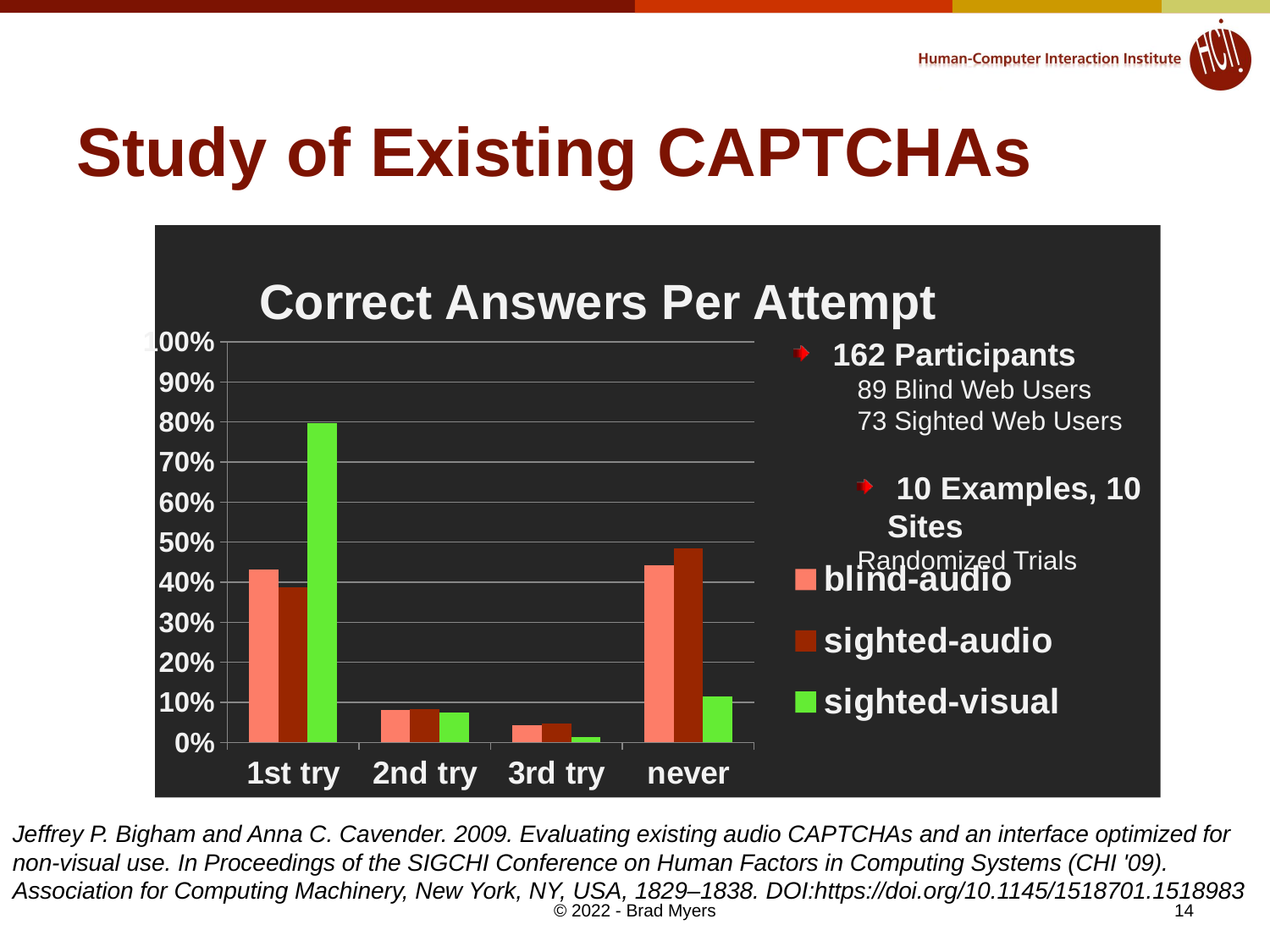
Which series has the lowest value for 'never'? sighted-visual What is the title of the chart? Correct Answers Per Attempt What kind of chart is shown on the slide? bar chart Is the blind-audio value for '3rd try' greater or less than 10%? less For the sighted-visual series, which category has the highest value? 1st try How many series does the chart's legend list? 3 Is the sighted-visual value for 'never' greater or less than 20%? less How many categories are shown on the x axis of the chart? 4 Is the sighted-audio value for 'never' greater or less than 40%? greater Which is larger for the blind-audio series: the value for '1st try' or the value for '2nd try'? 1st try Which series has the highest value for '1st try'? sighted-visual